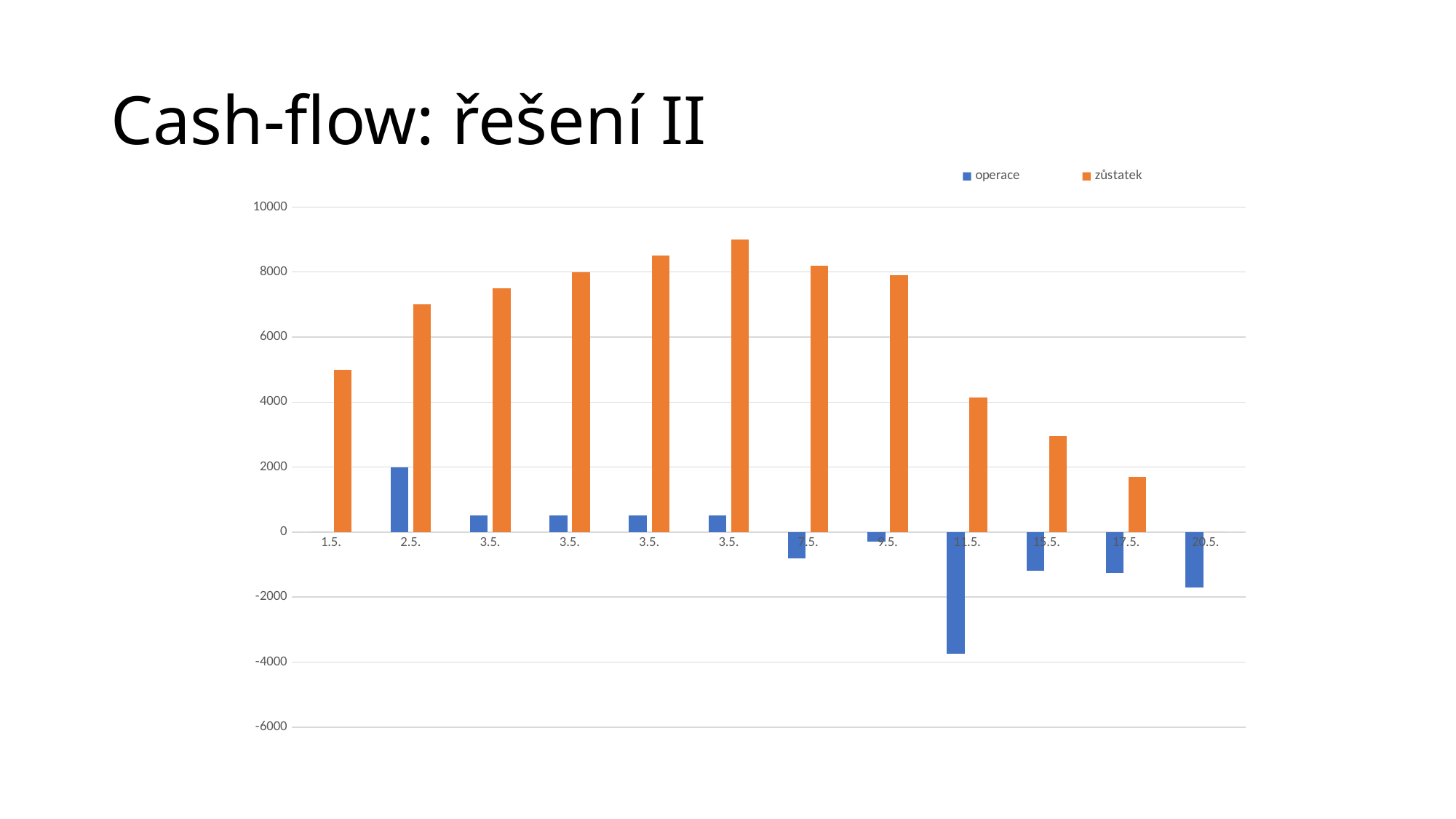
Is the zůstatek value for 17.5. greater or less than 2000? less How many series does the legend list? 2 Which date has the lowest zůstatek value? 20.5. Which date has the highest operace value? 2.5. Is the zůstatek value for 1.5. greater or less than 4000? greater Is the operace value for 11.5. greater or less than -2000? less Which is larger, the zůstatek value for 1.5. or for 2.5.? 2.5. What kind of chart is shown on the slide? bar chart Which date has the lowest operace value? 11.5. What are the two series named in the legend? operace and zůstatek How many date categories are shown on the x axis? 12 What colour are the zůstatek bars? orange